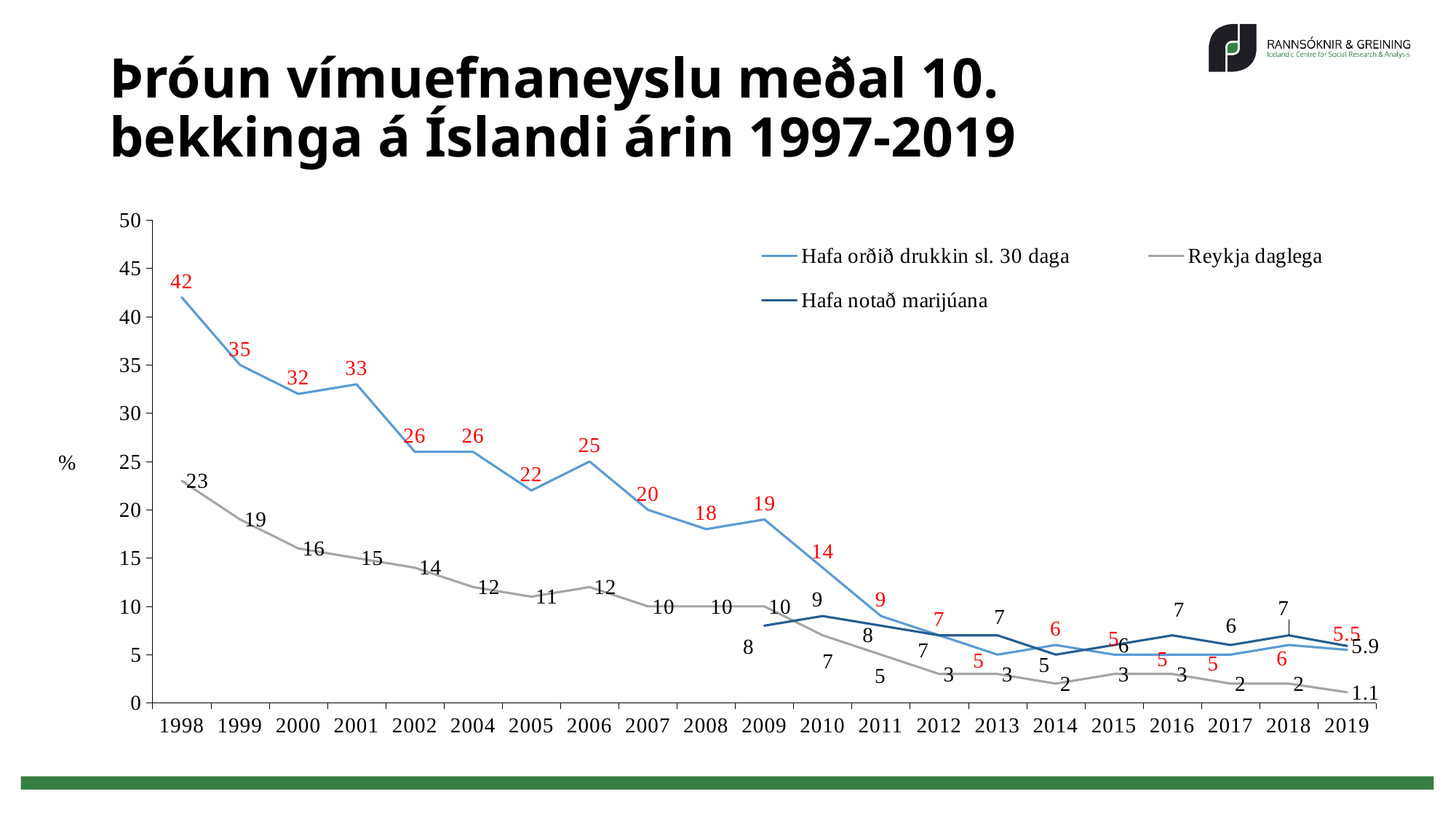
What is the difference between the "Reykja daglega" values in 1998 and 2019? 21.9 How many years are shown on the x axis? 21 What is the value for "Hafa notað marijúana" in 2019? 5.9 Does the "Reykja daglega" series generally rise or fall from 1998 to 2019? Fall What kind of chart is shown on the slide? Line chart What is the value for "Reykja daglega" in 2019? 1.1 What is the value for "Hafa orðið drukkin sl. 30 daga" in 1998? 42 In which year is the "Hafa orðið drukkin sl. 30 daga" series highest? 1998 How many series does the legend list? 3 What is the value for "Hafa notað marijúana" in 2010? 9 In 2001, which is larger: "Hafa orðið drukkin sl. 30 daga" or "Reykja daglega"? Hafa orðið drukkin sl. 30 daga Which legend entry corresponds to the gray line? Reykja daglega